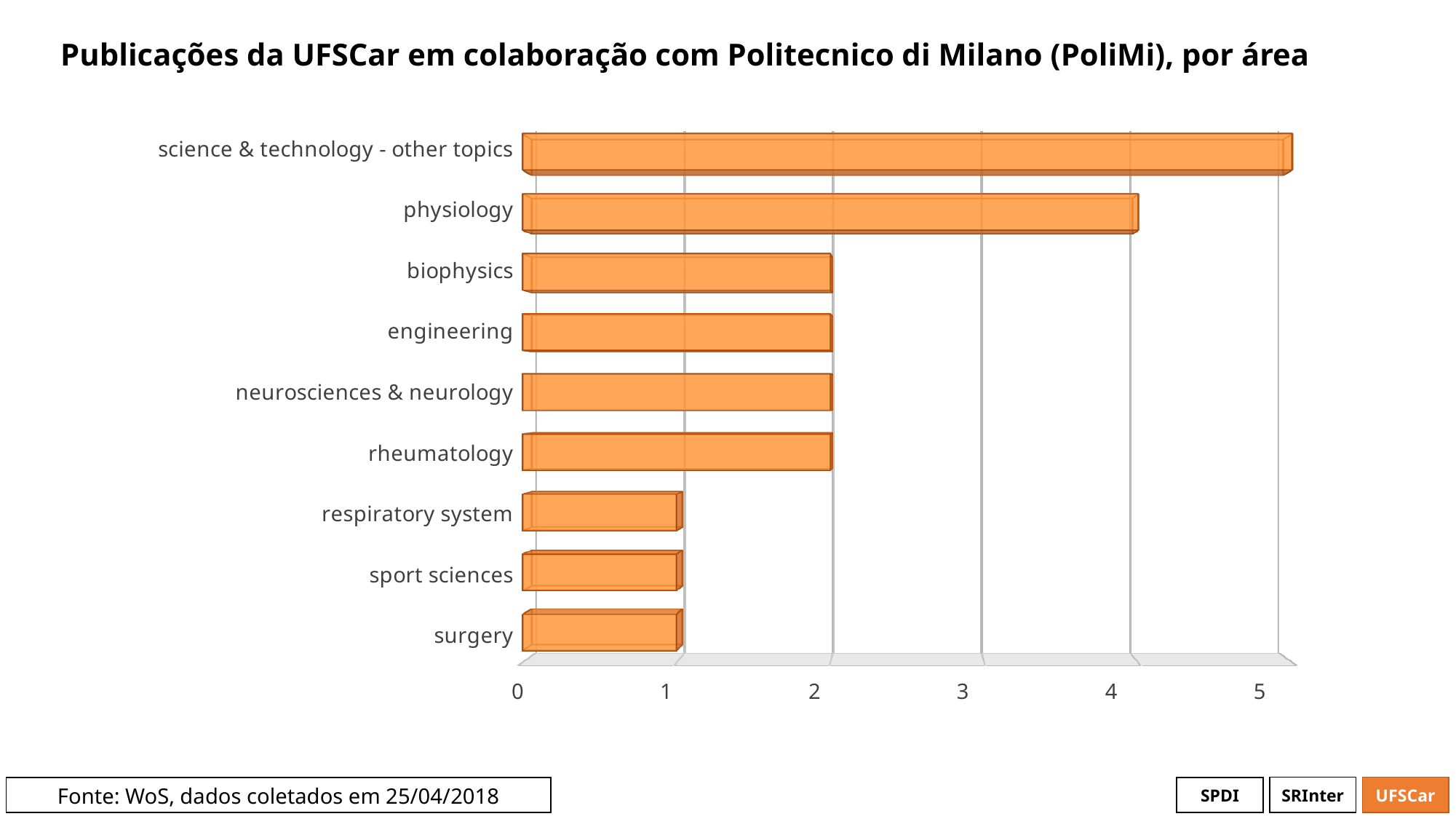
Is the value for physiology greater or less than 3? greater Which has more publications, physiology or engineering? physiology What is the title of the chart? Publicações da UFSCar em colaboração com Politecnico di Milano (PoliMi), por área How many publications are shown for science & technology - other topics? 5 How many publications are shown for physiology? 4 Which area has the highest number of publications? science & technology - other topics What kind of chart is shown on the slide? bar chart How many publications are shown for biophysics? 2 How many publications are shown for surgery? 1 Is the value for respiratory system greater or less than 2? less How many areas (categories) are shown in the chart? 9 What is the difference in publications between science & technology - other topics and physiology? 1